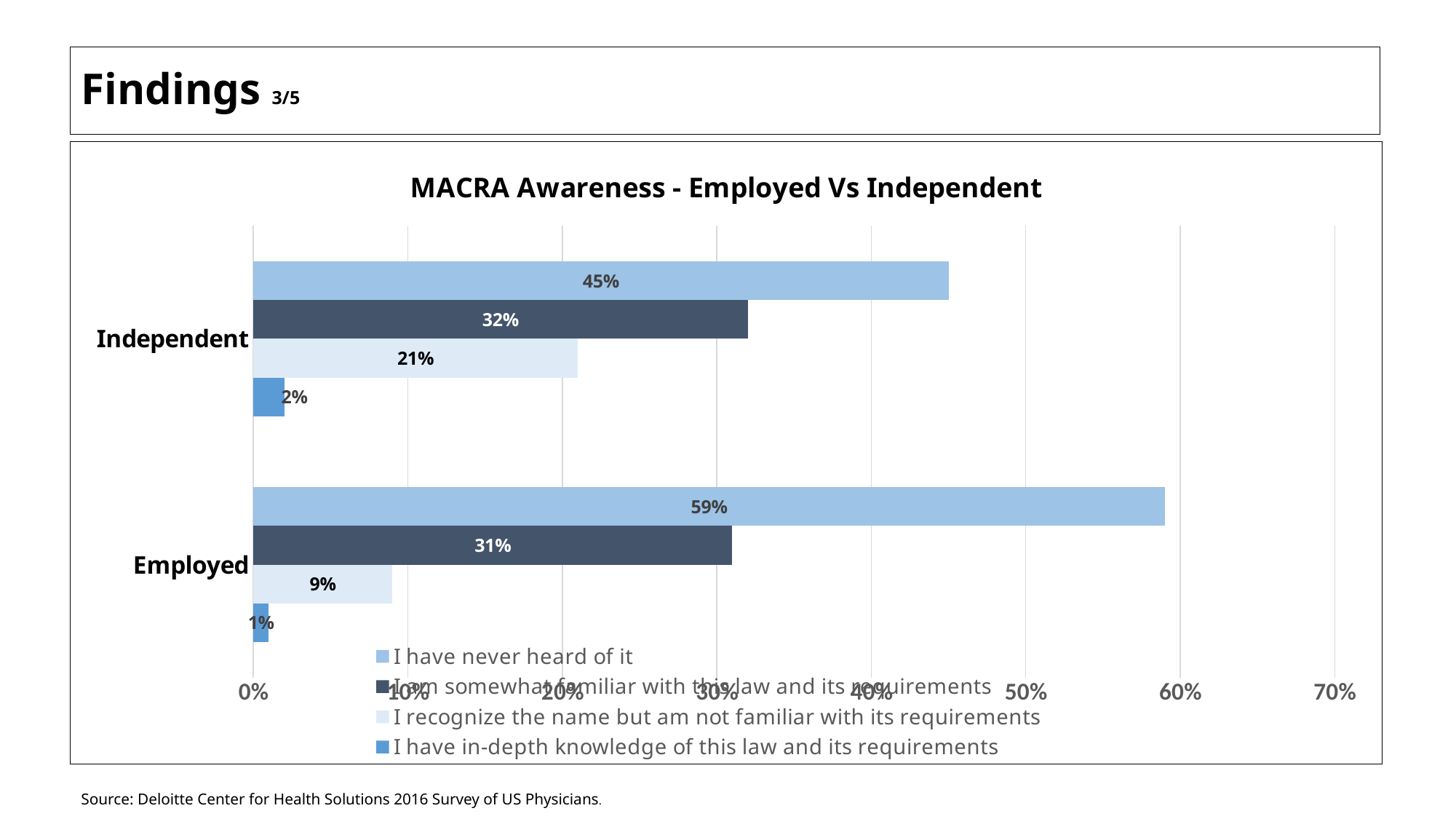
Which response category has the lowest value for Independent physicians? I have in-depth knowledge of this law and its requirements How many series does the legend list? 4 What is the difference between the Employed and Independent values for 'I have never heard of it'? 14% What percentage of Employed physicians recognize the name but are not familiar with its requirements? 9% What percentage of Independent physicians have in-depth knowledge of this law and its requirements? 2% Which response category has the highest value for Employed physicians? I have never heard of it What kind of chart is shown on the slide? Bar chart Which group has a larger share that recognizes the name but is not familiar with its requirements, Employed or Independent? Independent What percentage of Employed physicians said they have never heard of MACRA? 59% What is the title of the chart? MACRA Awareness - Employed Vs Independent How many groups (categories) are shown on the vertical axis? 2 What percentage of Independent physicians said they have never heard of MACRA? 45%